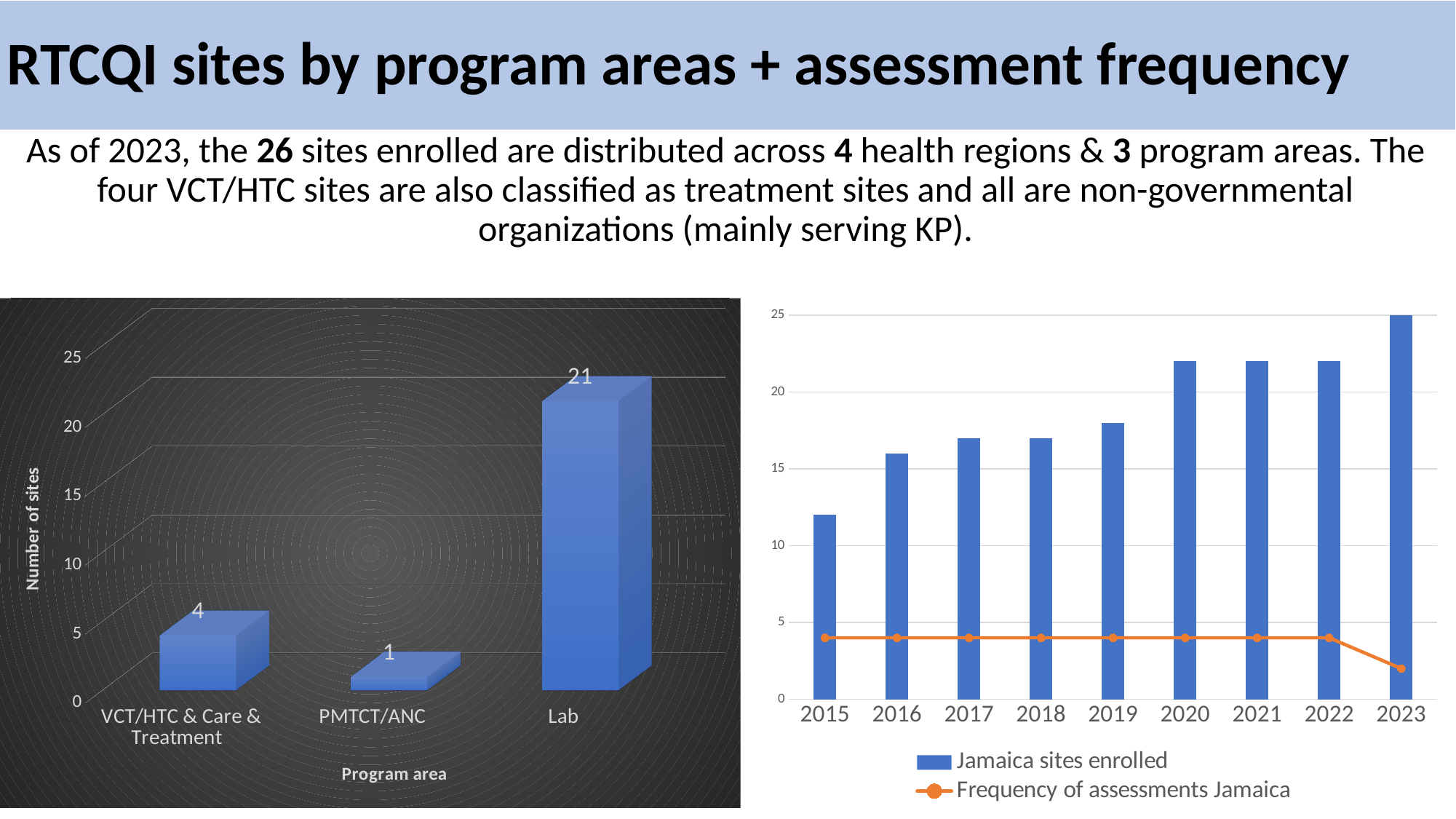
In the right chart, how many series does the legend list? 2 In the left chart, how many sites are in the Lab program area? 21 In the left chart, what is the difference in number of sites between Lab and VCT/HTC & Care & Treatment? 17 In the left chart, how many sites are in the VCT/HTC & Care & Treatment program area? 4 In the right chart, which year has the highest number of Jamaica sites enrolled? 2023 In the left chart, which program area has the most sites? Lab In the left chart, which program area has the fewest sites? PMTCT/ANC In the left chart, how many sites are in the PMTCT/ANC program area? 1 In the left chart, how many program areas are shown on the x axis? 3 In the right chart, is the value for Jamaica sites enrolled in 2015 greater or less than 15? less What kind of chart is the left chart? Bar chart In the right chart, do the Jamaica sites enrolled generally rise or fall from 2015 to 2023? Rise